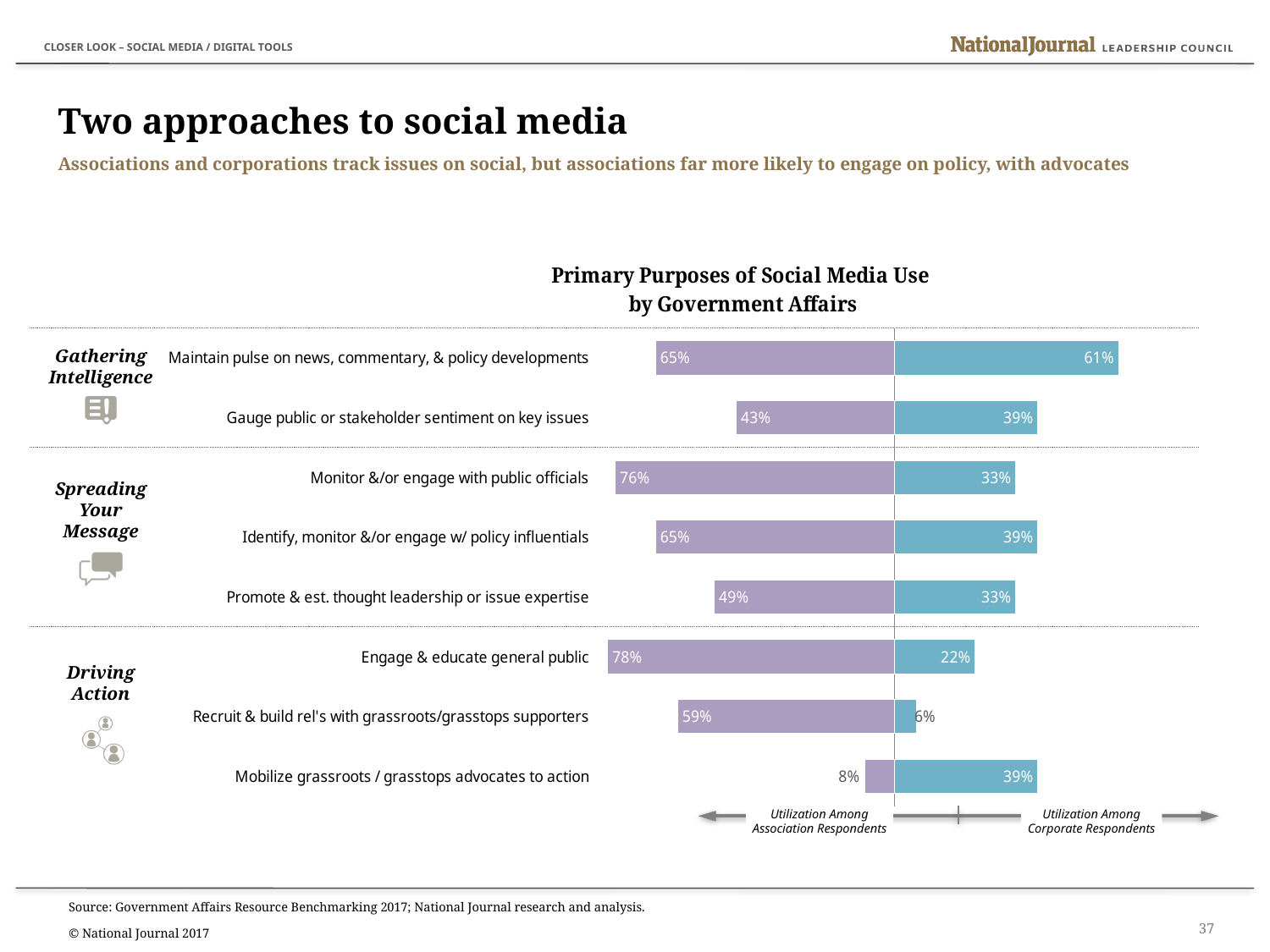
How many purposes of social media use are listed in the chart? 8 For 'Mobilize grassroots / grasstops advocates to action', which group has the higher value, association or corporate respondents? Corporate respondents What is the title of the chart? Primary Purposes of Social Media Use by Government Affairs What percentage of corporate respondents use social media to engage and educate the general public? 22% What percentage of association respondents use social media to monitor and/or engage with public officials? 76% What type of chart is used to show the primary purposes of social media use? Bar chart What is the value for corporate respondents for 'Recruit & build rel's with grassroots/grasstops supporters'? 6% Which purpose has the lowest utilization among association respondents? Mobilize grassroots / grasstops advocates to action Which purpose has the highest utilization among association respondents? Engage & educate general public Which purpose has the highest utilization among corporate respondents? Maintain pulse on news, commentary, & policy developments What is the difference between association and corporate respondents for 'Engage & educate general public'? 56 percentage points How many respondent groups does the chart compare? 2